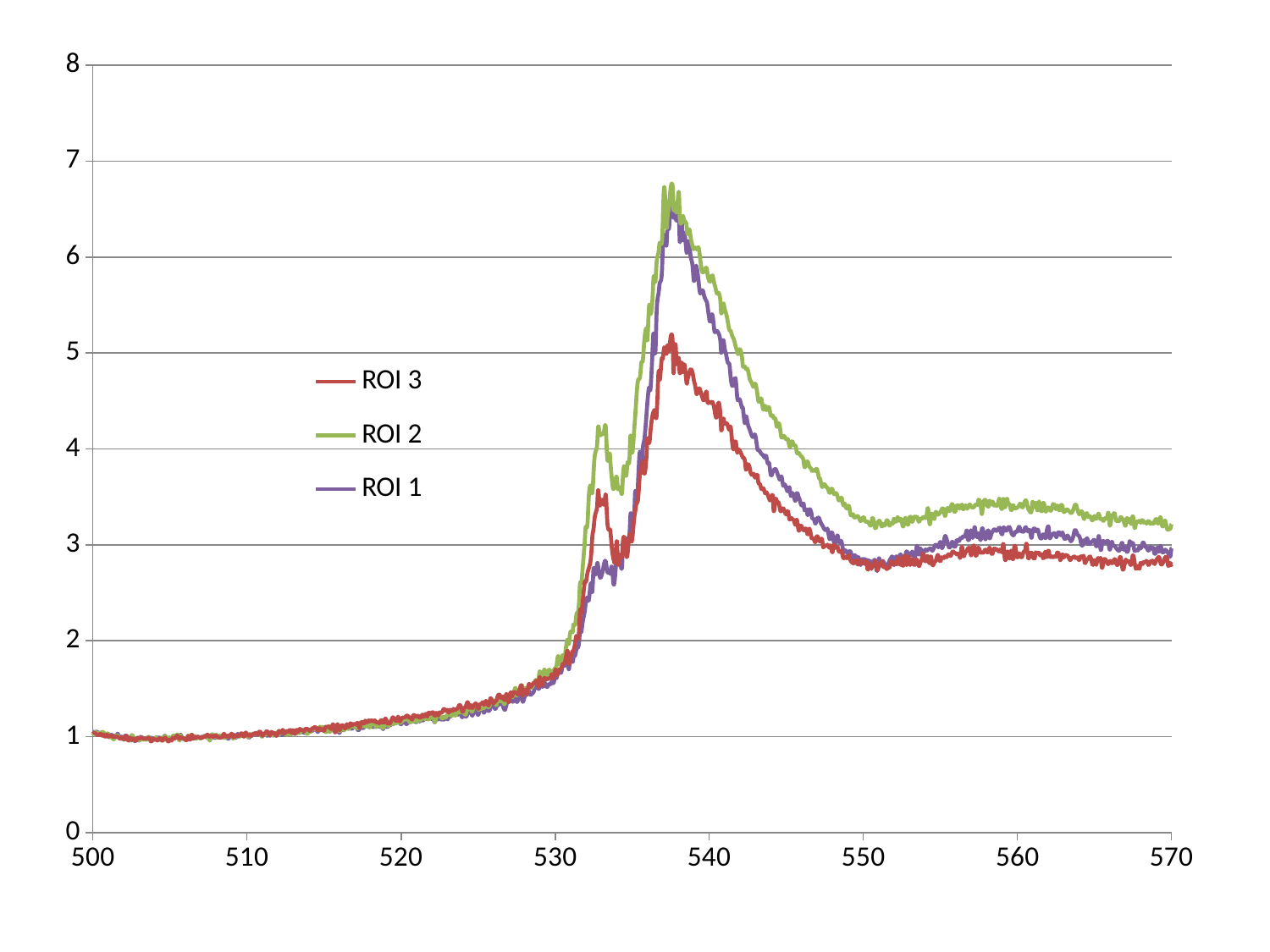
Between 540 and 550 on the x axis, do the values rise or fall? fall Is the peak value of ROI 3 greater or less than 6? less Which series has the highest value at the smaller peak near 533 on the x axis? ROI 2 What kind of chart is shown on the slide? line chart How many series does the legend list? 3 Is the peak value of ROI 2 greater or less than 6? greater Between 500 and 530 on the x axis, do the values rise or fall? rise At 500 on the x axis, are the values of the series greater or less than 2? less Which series reaches the lowest peak value near 537 on the x axis? ROI 3 Which series reaches the highest peak value near 537 on the x axis? ROI 2 At 560 on the x axis, which series has the larger value, ROI 2 or ROI 3? ROI 2 What colour is the line for ROI 1? purple